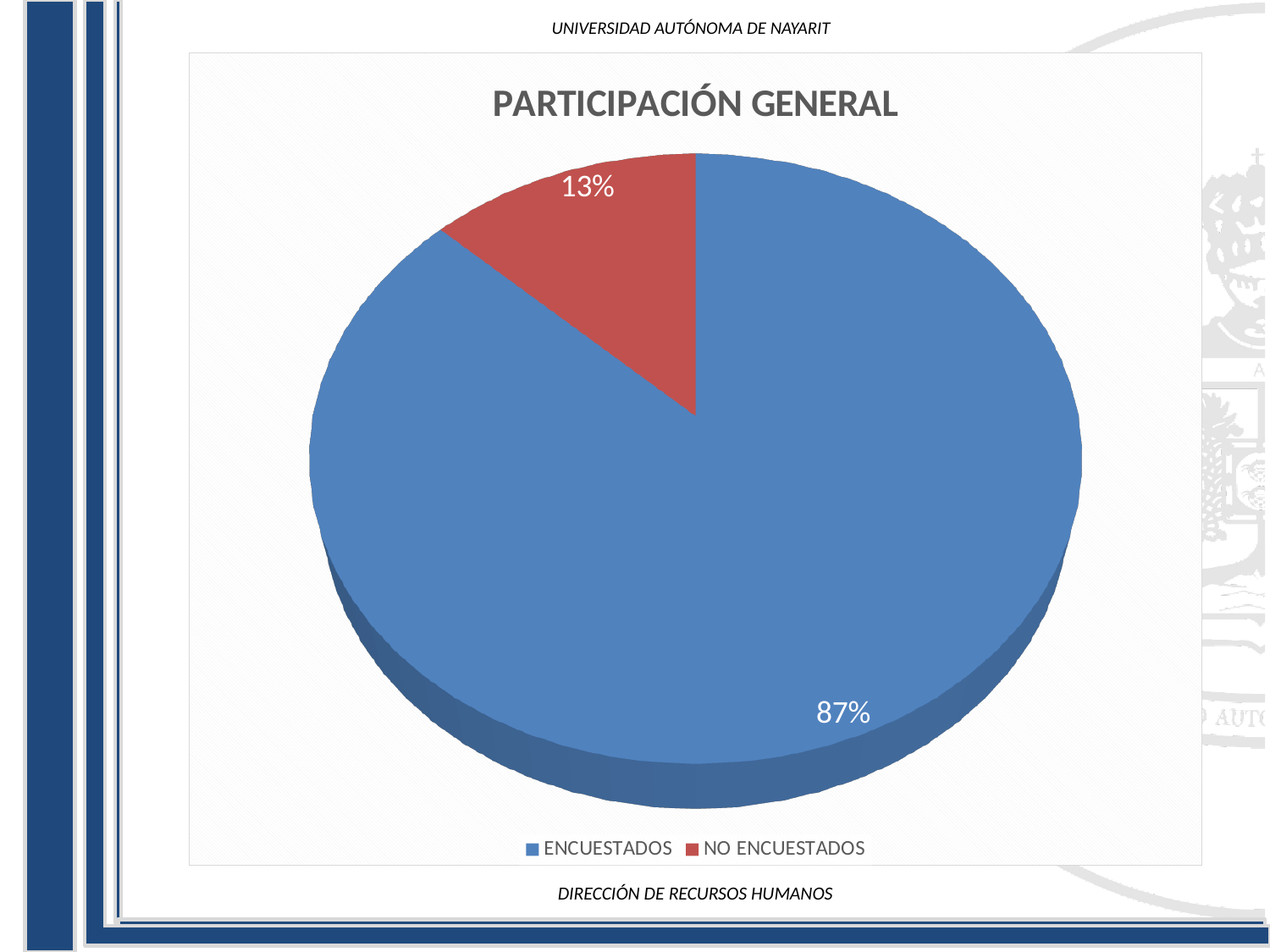
Which is larger, the share for ENCUESTADOS or for NO ENCUESTADOS? ENCUESTADOS Which category has the largest share of the pie? ENCUESTADOS How many slices does the pie chart have? 2 Which category has the smallest share of the pie? NO ENCUESTADOS What percentage of the pie is NO ENCUESTADOS? 13% What percentage of the pie is ENCUESTADOS? 87% How many entries does the legend list? 2 What is the title of the chart? PARTICIPACIÓN GENERAL What colour is the NO ENCUESTADOS slice? red What kind of chart is shown on the slide? pie chart What is the difference in percentage points between ENCUESTADOS and NO ENCUESTADOS? 74